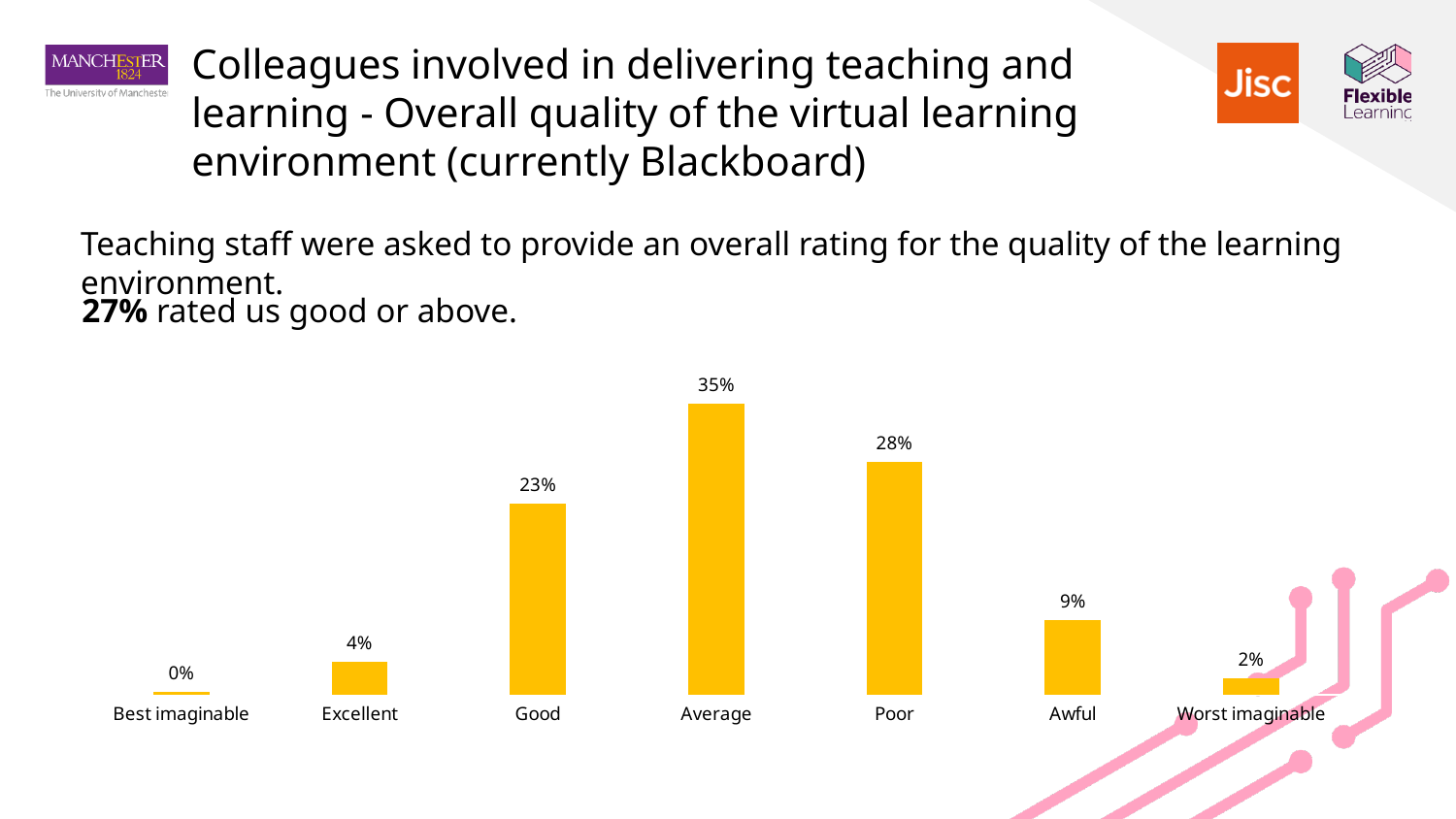
What is the difference in percentage points between the Good and Awful ratings? 14 What colour are the bars in the chart? Yellow Which rating category has the highest percentage? Average What percentage of teaching staff rated the virtual learning environment as Poor? 28% What percentage of teaching staff rated the virtual learning environment as Average? 35% What type of chart is used to show the ratings? Bar chart What is the difference in percentage points between the Average and Poor ratings? 7 What percentage of teaching staff rated the virtual learning environment as Worst imaginable? 2% What percentage of teaching staff rated the virtual learning environment as Excellent? 4% Which rating category has the lowest percentage? Best imaginable Which rating received a larger share: Good or Poor? Poor How many rating categories are shown on the chart? 7